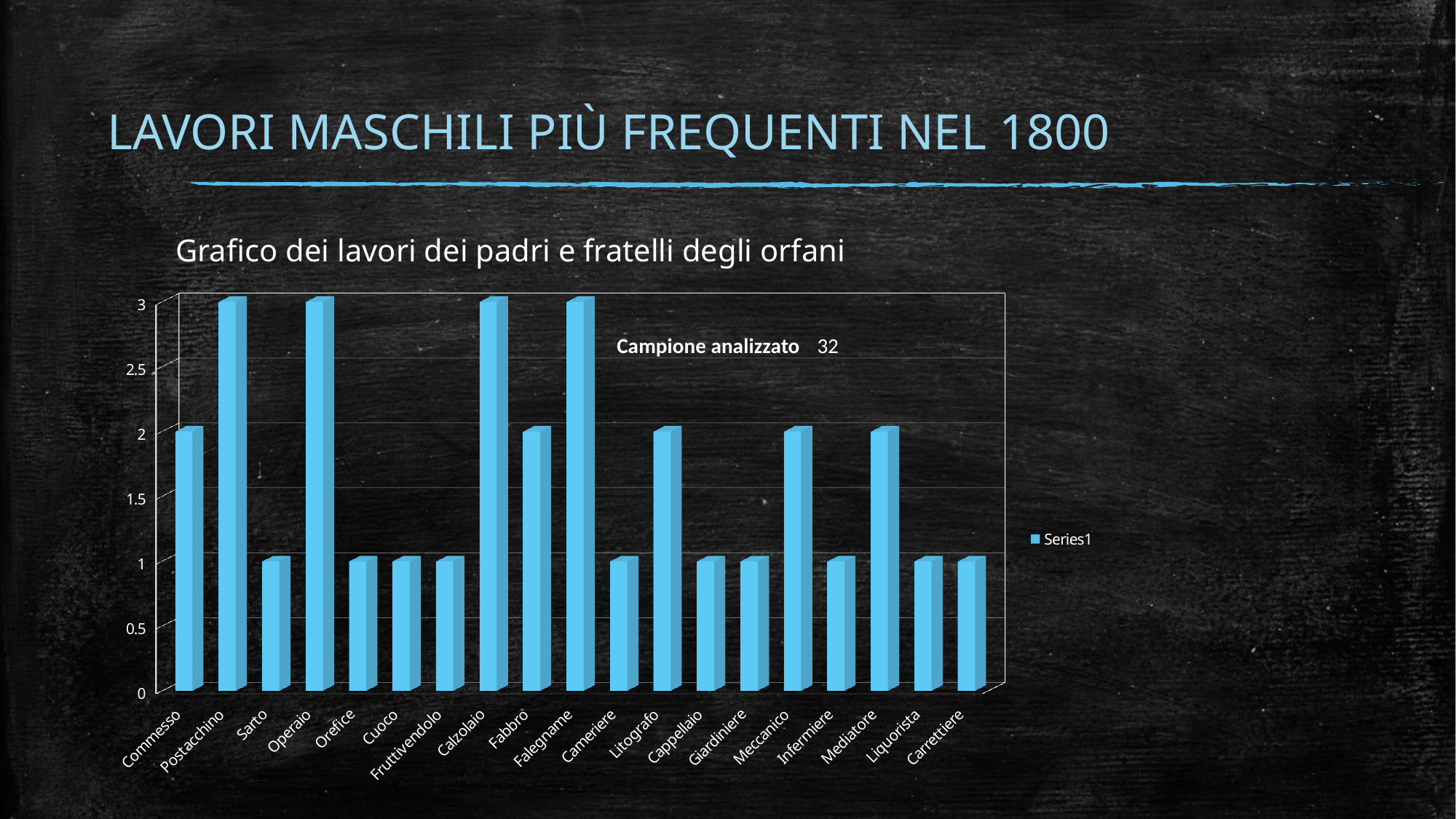
What kind of chart is shown on the slide? Bar chart What is the name of the series listed in the legend? Series1 How many categories (jobs) are shown on the x axis? 19 Which has a larger value, Fabbro or Cuoco? Fabbro Is the value for Litografo greater or less than 1.5? greater What is the highest value reached by any bar in the chart? 3 What is the value for Sarto? 1 What is the value for Commesso? 2 What is the value for Mediatore? 2 What is the difference between the values for Postacchino and Sarto? 2 How many series does the legend list? 1 What is the value for Calzolaio? 3